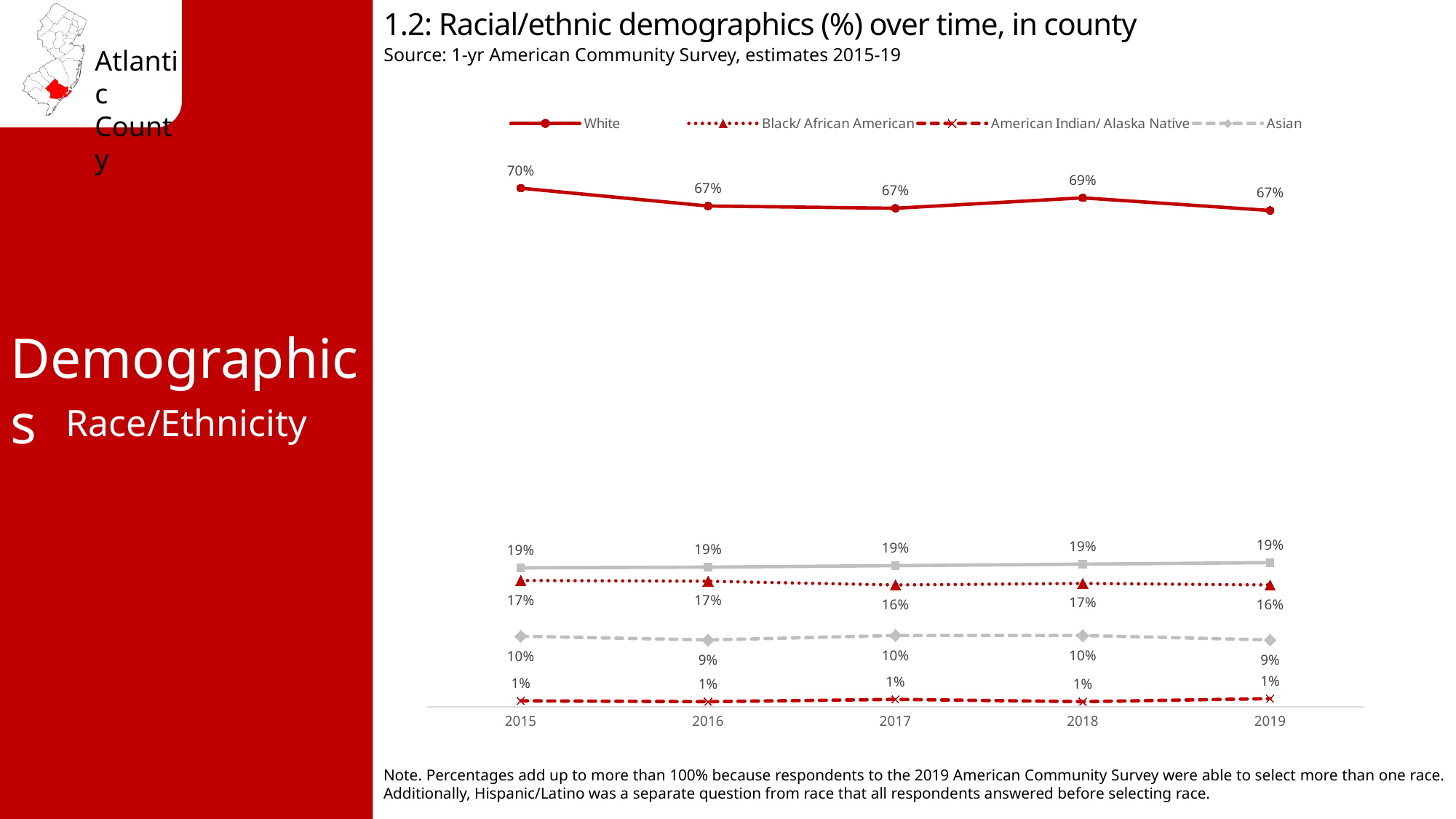
Which series has the lowest values across all years? American Indian/ Alaska Native What was the White share in 2015? 70% What is the difference between the White share in 2015 and in 2019? 3% What was the Black/ African American share in 2019? 16% Which was larger in 2017, the Black/ African American share or the Asian share? Black/ African American What kind of chart is this? Line chart Did the White share rise or fall from 2015 to 2016? Fall In which year was the White share highest? 2015 How many years are shown on the x axis? 5 What was the Asian share in 2016? 9% What was the American Indian/ Alaska Native share in 2018? 1% What is the source cited under the chart title? 1-yr American Community Survey, estimates 2015-19